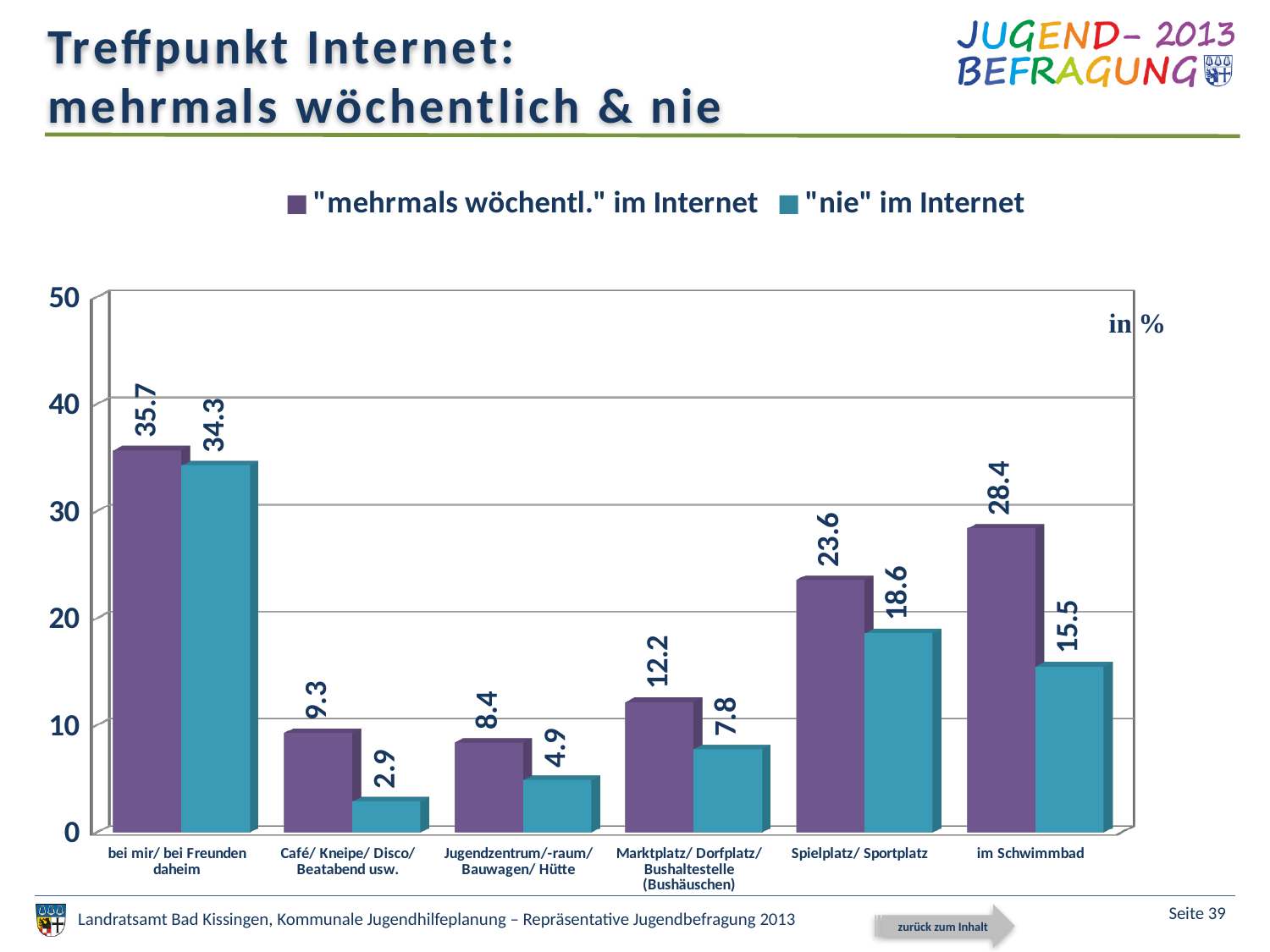
What is the difference between the "mehrmals wöchentl." im Internet and "nie" im Internet values for "Spielplatz/ Sportplatz"? 5.0 How many categories are shown on the x axis of the chart? 6 Which category has the lowest value for "nie" im Internet? Café/ Kneipe/ Disco/ Beatabend usw. How many series does the legend list? 2 What is the value for "nie" im Internet for "Spielplatz/ Sportplatz"? 18.6 For "Jugendzentrum/-raum/ Bauwagen/ Hütte", which series has the larger value: "mehrmals wöchentl." im Internet or "nie" im Internet? "mehrmals wöchentl." im Internet What is the value for "nie" im Internet for "Café/ Kneipe/ Disco/ Beatabend usw."? 2.9 What is the value for "mehrmals wöchentl." im Internet for "im Schwimmbad"? 28.4 Which category has the highest value for "mehrmals wöchentl." im Internet? bei mir/ bei Freunden daheim What is the difference between the "mehrmals wöchentl." im Internet and "nie" im Internet values for "im Schwimmbad"? 12.9 What kind of chart is shown on the slide? bar chart Is the value for "nie" im Internet for "Marktplatz/ Dorfplatz/ Bushaltestelle (Bushäuschen)" greater or less than 10? less